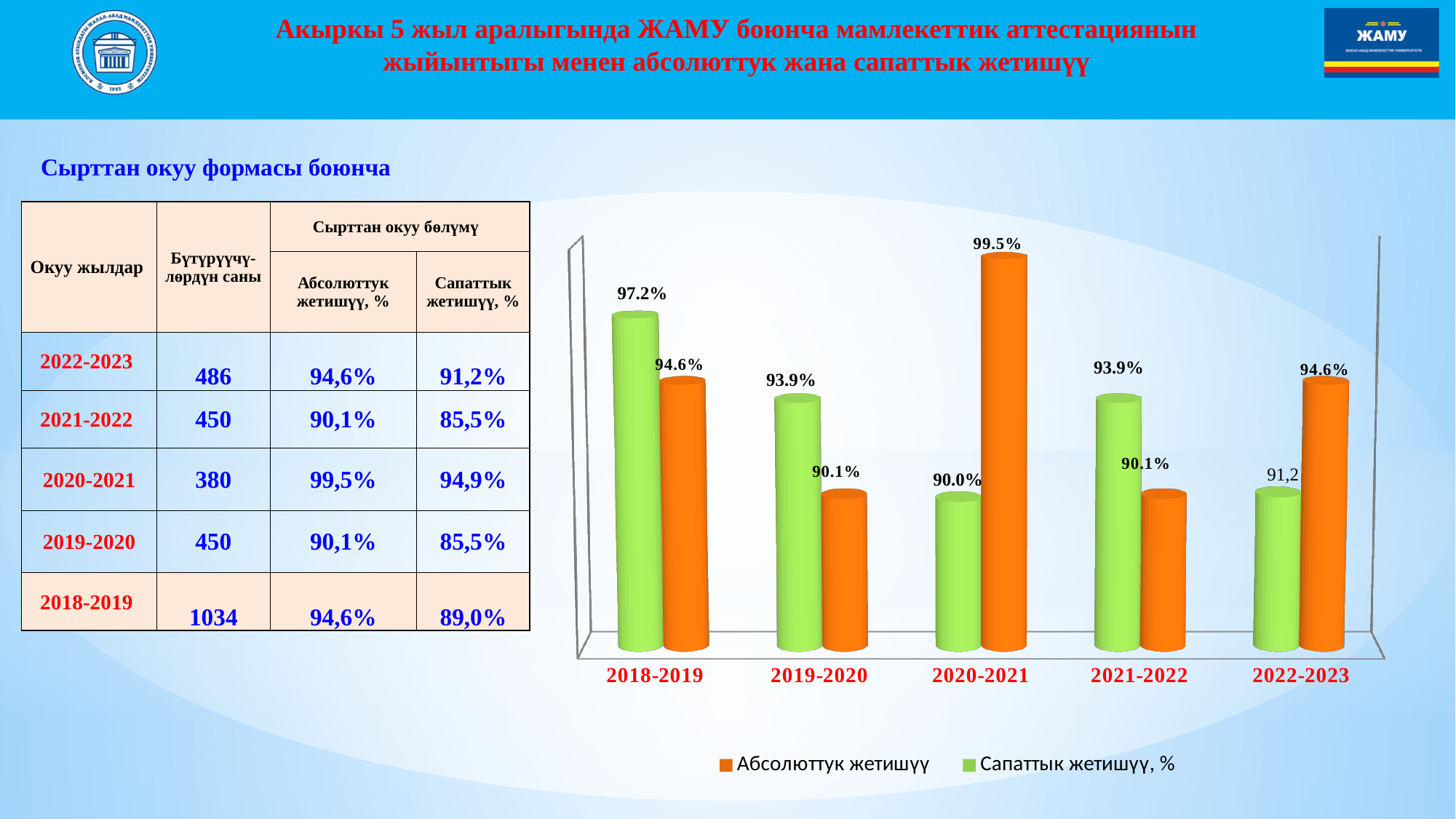
What is the Сапаттык жетишүү value for 2018-2019 in the chart? 97.2% How many series does the chart legend list? 2 What kind of chart is shown on the slide? Bar chart In the chart, what is the difference between Абсолюттук жетишүү and Сапаттык жетишүү for 2020-2021? 9.5 percentage points Which academic year has the lowest Сапаттык жетишүү value in the chart? 2020-2021 Which academic year has the highest Абсолюттук жетишүү value in the chart? 2020-2021 In the chart, what is the difference between Сапаттык жетишүү and Абсолюттук жетишүү for 2018-2019? 2.6 percentage points What is the Сапаттык жетишүү data label for 2022-2023 in the chart? 91,2 For 2018-2019, which is larger in the chart: Абсолюттук жетишүү or Сапаттык жетишүү? Сапаттык жетишүү What is the Абсолюттук жетишүү value for 2020-2021 in the chart? 99.5% How many academic years are shown on the x axis of the chart? 5 Which academic year has the highest Сапаттык жетишүү value in the chart? 2018-2019